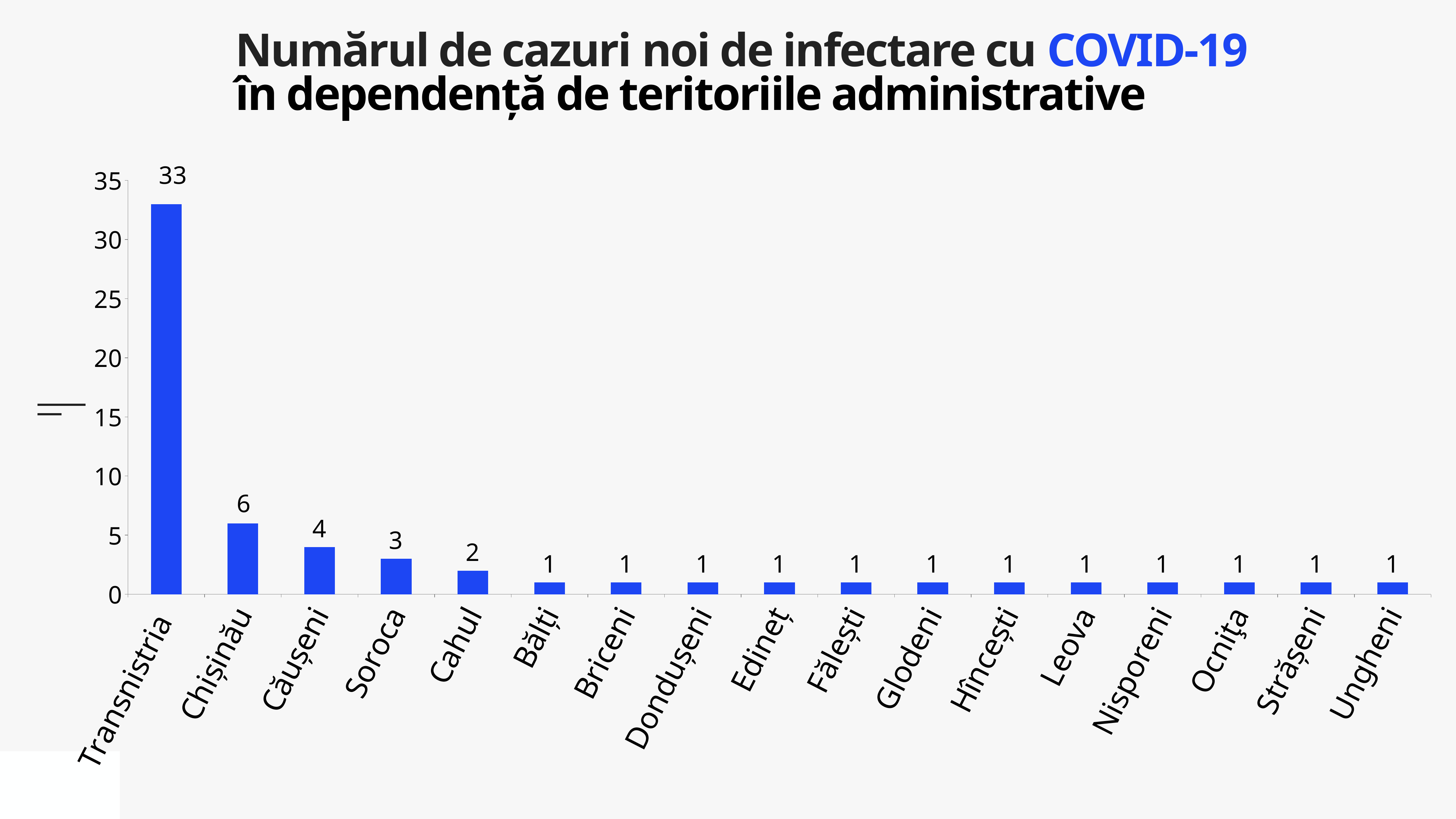
What is the value for Chișinău? 6 Which category has the highest value? Transnistria What is the difference between the values for Transnistria and Chișinău? 27 What is the value for Cahul? 2 Is the value for Transnistria greater or less than 30? greater What is the value for Soroca? 3 What is the value for Transnistria? 33 What is the value for Ungheni? 1 What is the difference between the values for Căușeni and Cahul? 2 What kind of chart is shown on the slide? bar chart Which is larger, the value for Chișinău or the value for Căușeni? Chișinău How many categories are shown on the x axis? 17